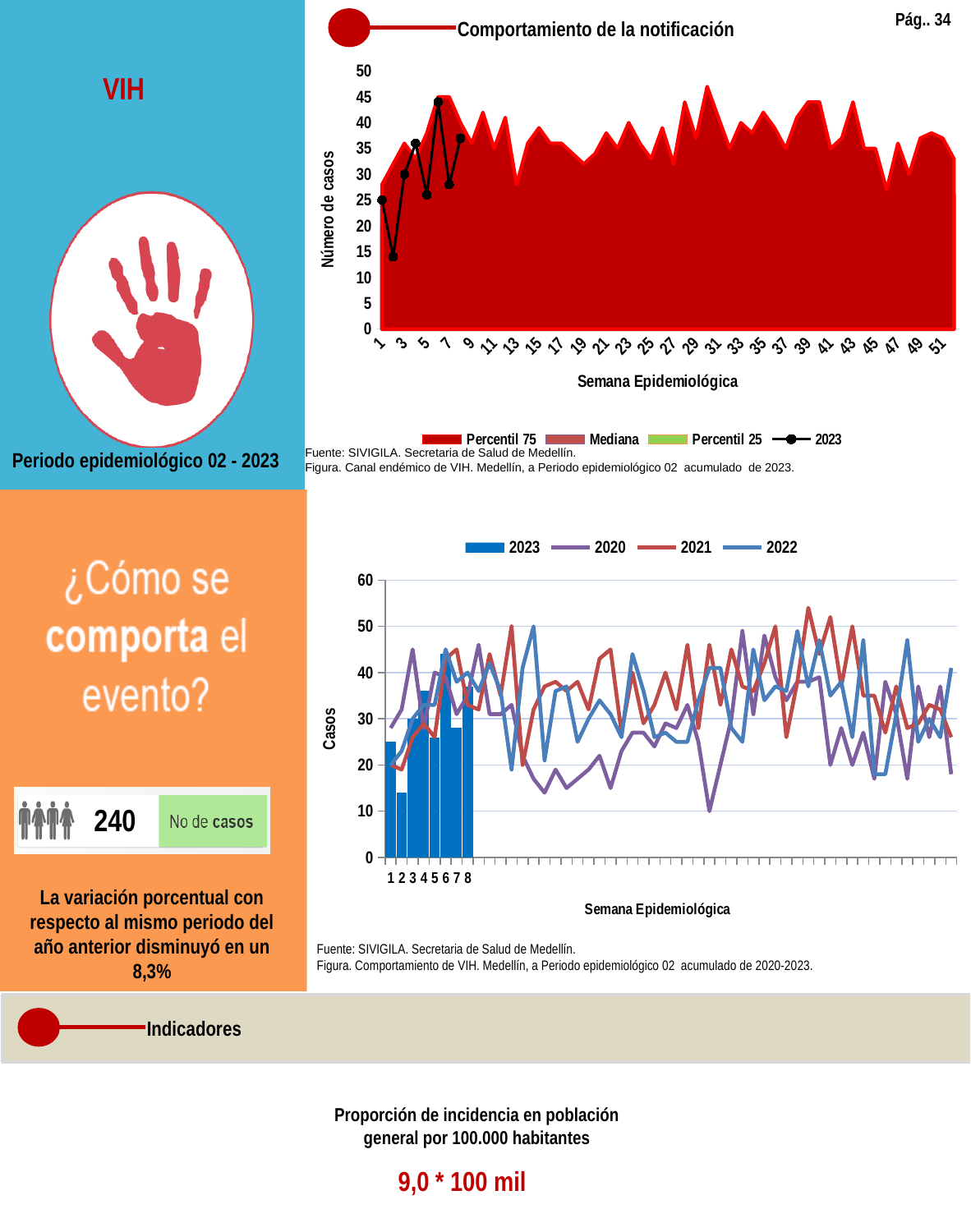
In the bottom chart (Comportamiento de VIH 2020-2023), which week has the highest 2023 bar? 6 In the bottom chart (Comportamiento de VIH 2020-2023), how many bars are plotted for the 2023 series? 8 In the top chart 'Comportamiento de la notificación', is the 2023 value for week 6 greater or less than 40? greater In the top chart 'Comportamiento de la notificación', is the 2023 value for week 2 greater or less than 20? less In the top chart 'Comportamiento de la notificación', what is the title of the vertical axis? Número de casos In the bottom chart (Comportamiento de VIH 2020-2023), is the 2023 bar for week 4 larger or smaller than the 2023 bar for week 5? larger In the top chart 'Comportamiento de la notificación', what is the highest value shown on the vertical axis? 50 In the bottom chart (Comportamiento de VIH 2020-2023), how many series does the legend list? 4 In the top chart 'Comportamiento de la notificación', which epidemiological week has the lowest value on the 2023 line? 2 In the top chart 'Comportamiento de la notificación', how many series does the legend list? 4 In the top chart 'Comportamiento de la notificación', which epidemiological week has the highest value on the 2023 line? 6 In the bottom chart (Comportamiento de VIH 2020-2023), which week has the lowest 2023 bar? 2